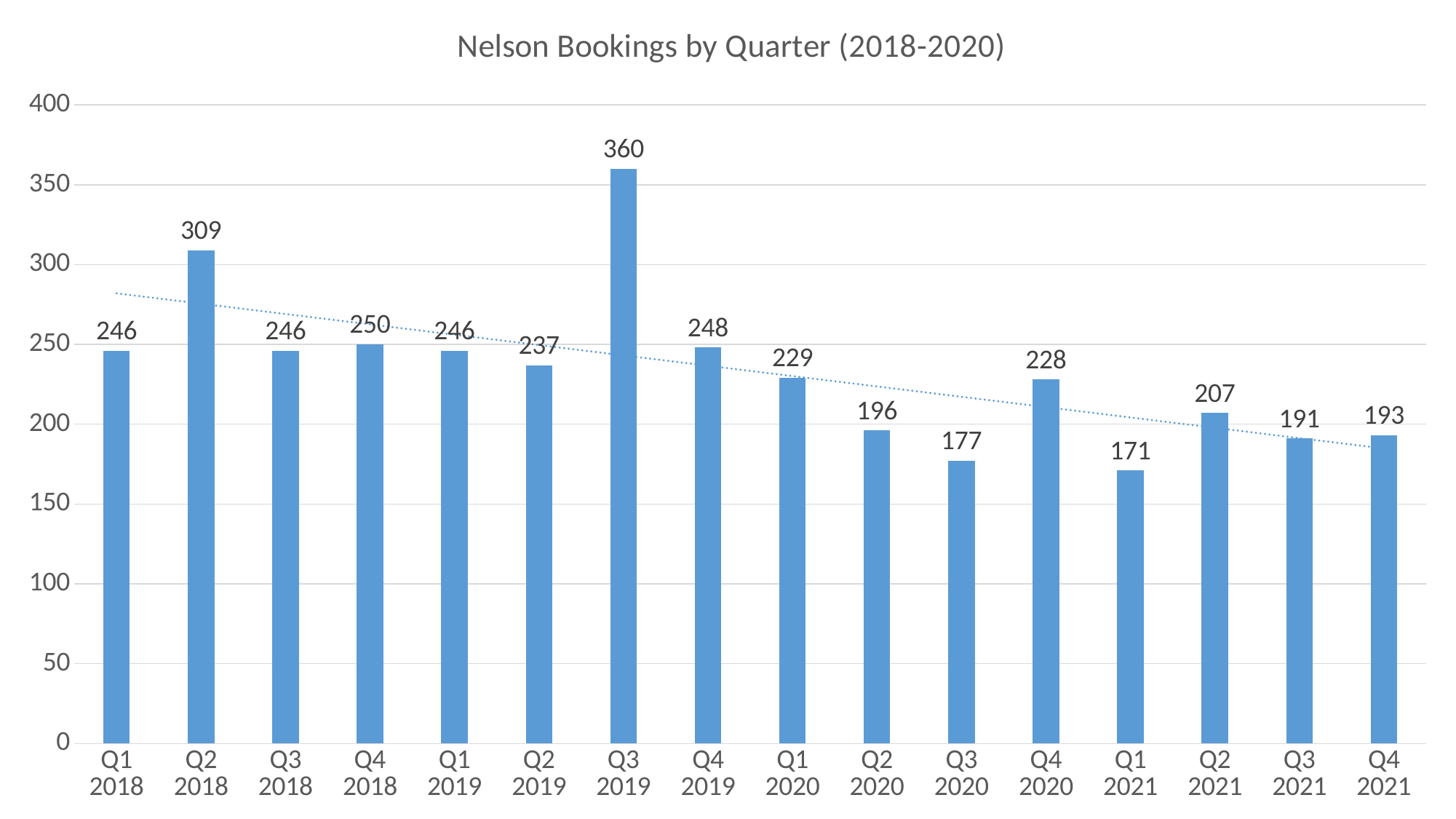
What is the value for Q3 2019? 360 Is the value for Q3 2020 greater or less than 200? less Which quarter has the highest number of bookings? Q3 2019 Do the values generally rise or fall from Q1 2018 to Q4 2021? fall Which is larger, the value for Q2 2020 or the value for Q4 2020? Q4 2020 What is the value for Q1 2021? 171 What is the title of the chart? Nelson Bookings by Quarter (2018-2020) What is the value for Q2 2018? 309 Which quarter has the lowest number of bookings? Q1 2021 What kind of chart is this? bar chart How many quarters are shown on the x axis? 16 What is the difference between the values for Q3 2019 and Q4 2019? 112